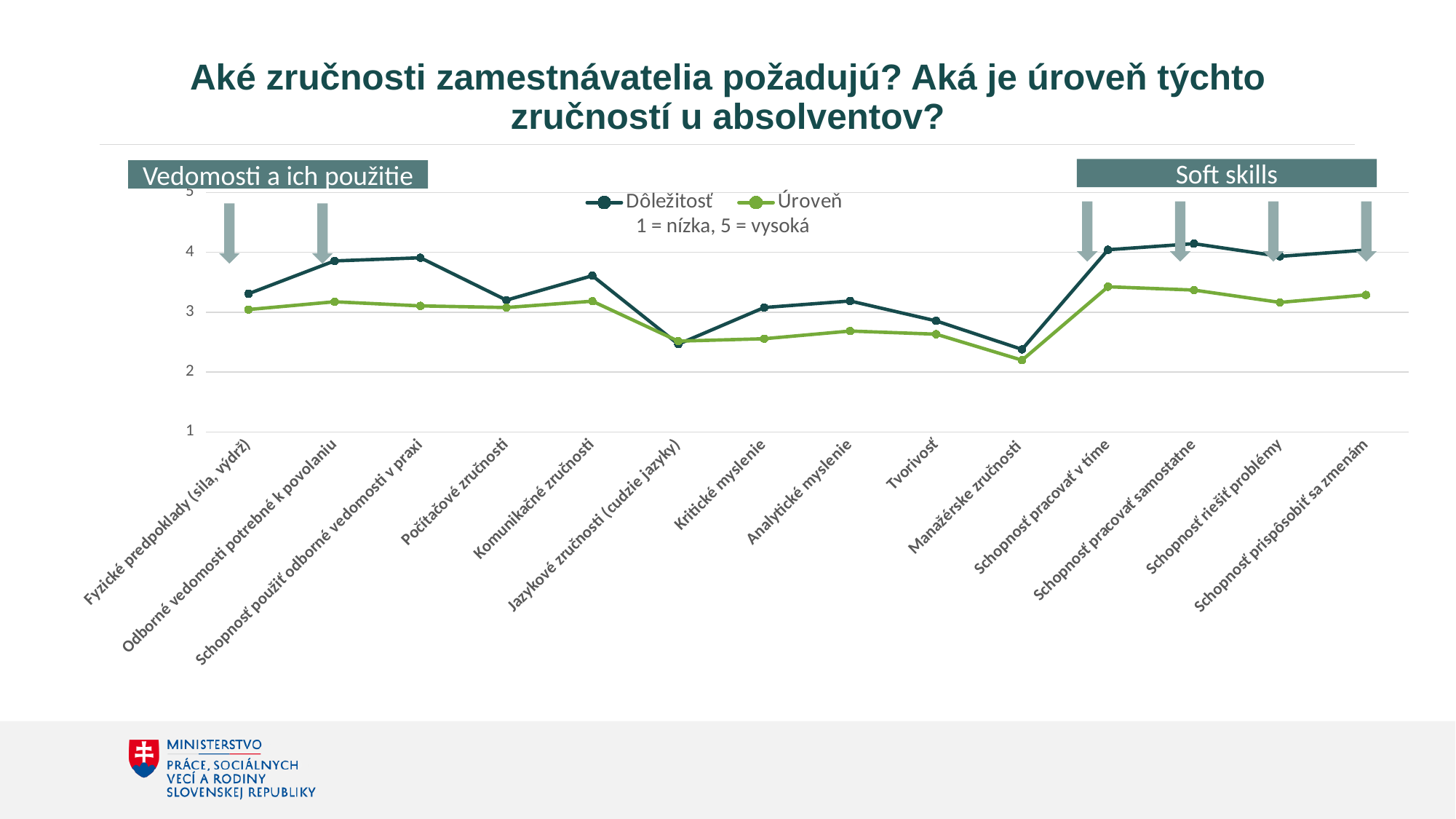
Which has the larger Dôležitosť value, Kritické myslenie or Tvorivosť? Kritické myslenie How many categories are plotted along the x axis? 14 How many series does the legend list? 2 Is the Dôležitosť value for Komunikačné zručnosti greater or less than 3? greater For Komunikačné zručnosti, which series has the larger value, Dôležitosť or Úroveň? Dôležitosť Is the Dôležitosť value for Odborné vedomosti potrebné k povolaniu greater or less than 4? less Does the Dôležitosť line rise or fall from Manažérske zručnosti to Schopnosť pracovať v tíme? rise Is the Úroveň value for Manažérske zručnosti greater or less than 3? less Which category has the lowest Úroveň value? Manažérske zručnosti What scale note is shown under the legend? 1 = nízka, 5 = vysoká What kind of chart is shown on the slide? line chart